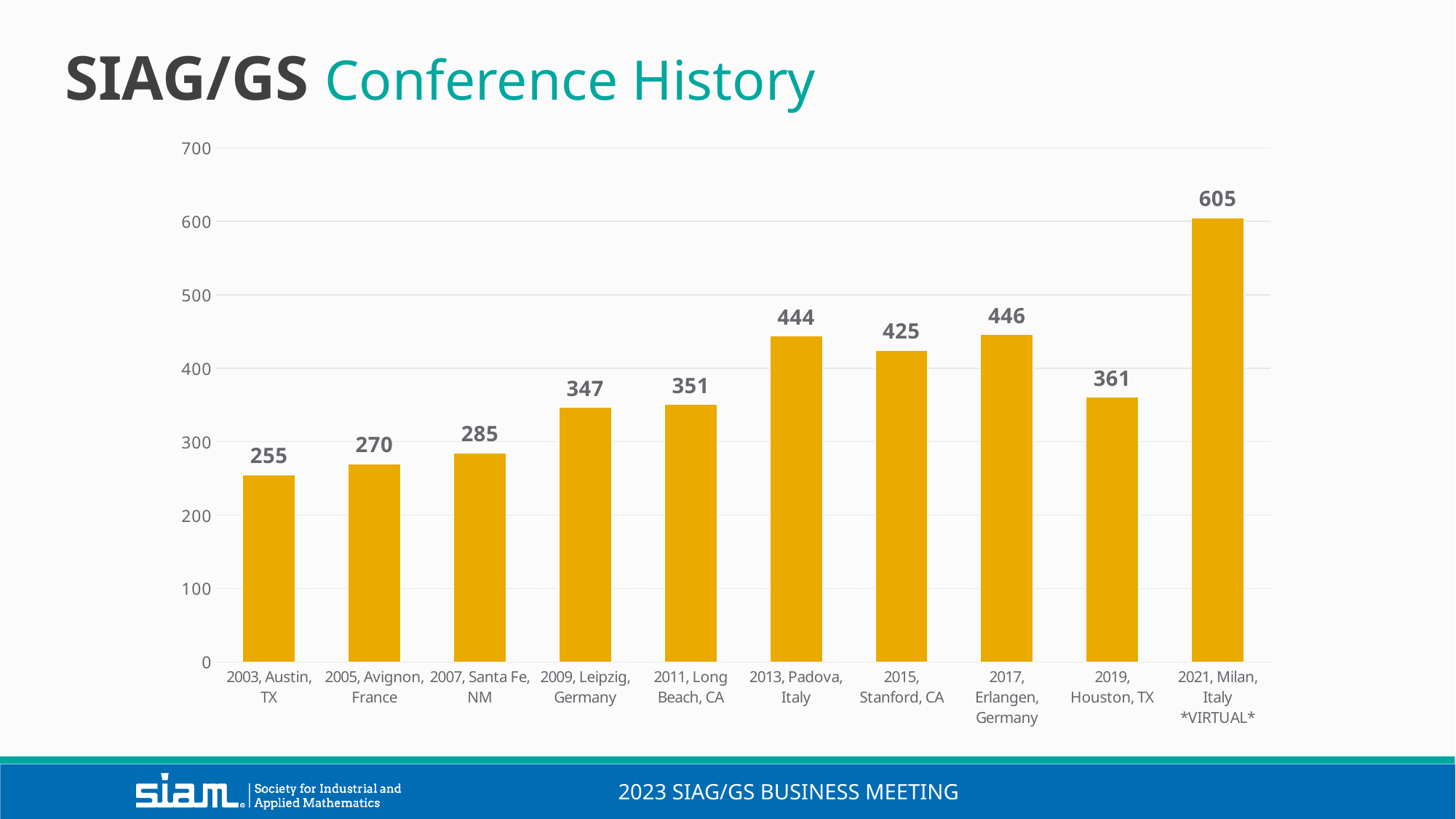
What is the value for 2013, Padova, Italy? 444 Is the value for 2011, Long Beach, CA greater or less than 400? less What is the difference between the values for 2021, Milan, Italy *VIRTUAL* and 2019, Houston, TX? 244 Which is larger, the value for 2015, Stanford, CA or the value for 2017, Erlangen, Germany? 2017, Erlangen, Germany Which conference has the highest value? 2021, Milan, Italy *VIRTUAL* What kind of chart is shown on the slide? bar chart Which conference has the lowest value? 2003, Austin, TX What is the value for 2003, Austin, TX? 255 What is the title of the slide containing the chart? SIAG/GS Conference History How many conferences are shown on the chart? 10 What is the value for 2019, Houston, TX? 361 What is the difference between the values for 2009, Leipzig, Germany and 2007, Santa Fe, NM? 62